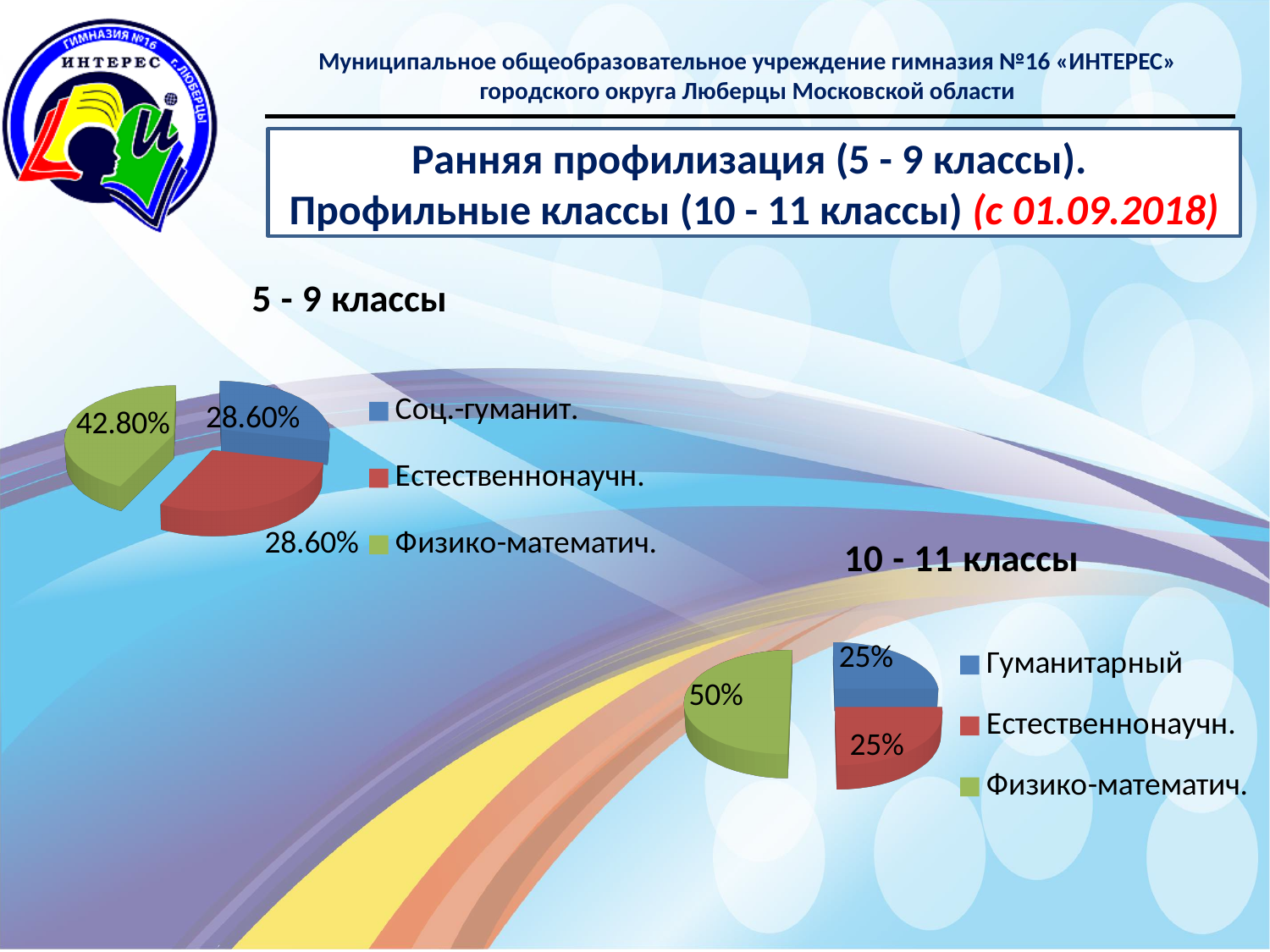
In the "5 - 9 классы" chart, which category has the largest share? Физико-математич. In the "5 - 9 классы" chart, what share is shown for Соц.-гуманит.? 28.60% In the "5 - 9 классы" chart, what share is shown for Физико-математич.? 42.80% In the "5 - 9 классы" chart, what is the difference between the Физико-математич. share and the Естественнонаучн. share? 14.20% In the "10 - 11 классы" chart, what share is shown for Физико-математич.? 50% In the "10 - 11 классы" chart, what share is shown for Гуманитарный? 25% In the "10 - 11 классы" chart, which colour represents Естественнонаучн.? Red In the "10 - 11 классы" chart, what is the difference between the Физико-математич. share and the Гуманитарный share? 25% In the "5 - 9 классы" chart, how many categories does the legend list? 3 In the "10 - 11 классы" chart, which category has the largest share? Физико-математич. In the "10 - 11 классы" chart, which is larger: the share for Физико-математич. or the share for Естественнонаучн.? Физико-математич. What type of chart is the "5 - 9 классы" chart? Pie chart